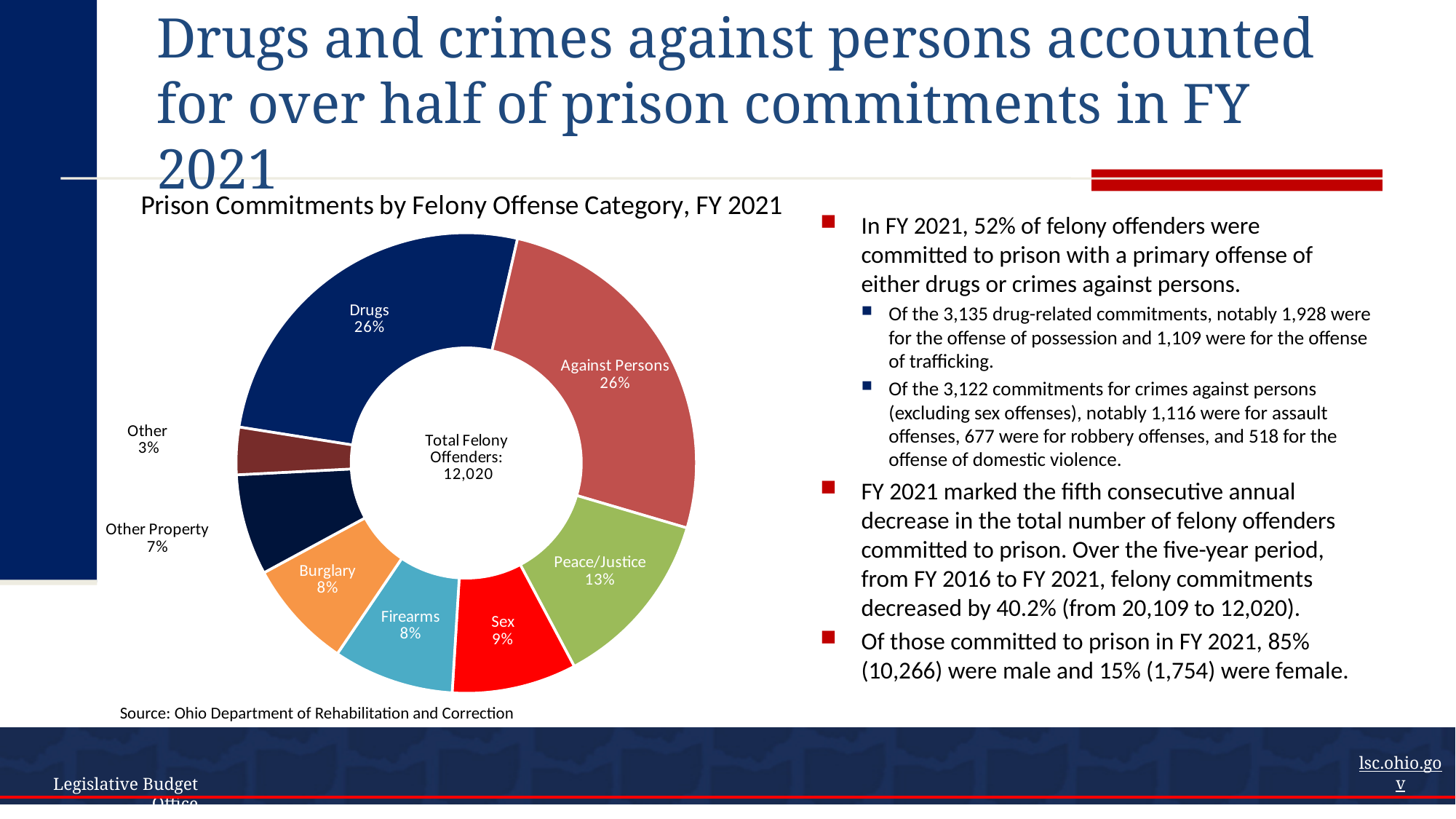
Which is larger, the share for Against Persons or the share for Burglary? Against Persons How many percentage points larger is the Drugs share than the Peace/Justice share? 13 How many offense categories are shown in the chart? 8 Which is larger, the share for Peace/Justice or the share for Sex? Peace/Justice What percentage is shown for the Sex offense category? 9% What share of prison commitments does the Drugs slice represent? 26% How many percentage points larger is the Firearms share than the Other share? 5 What is the total number of felony offenders shown in the center of the chart? 12,020 What percentage is shown for Other Property? 7% What percentage is shown for the Peace/Justice category? 13% Which offense category has the smallest share of prison commitments? Other What type of chart is used to show prison commitments by felony offense category? Doughnut (donut) chart